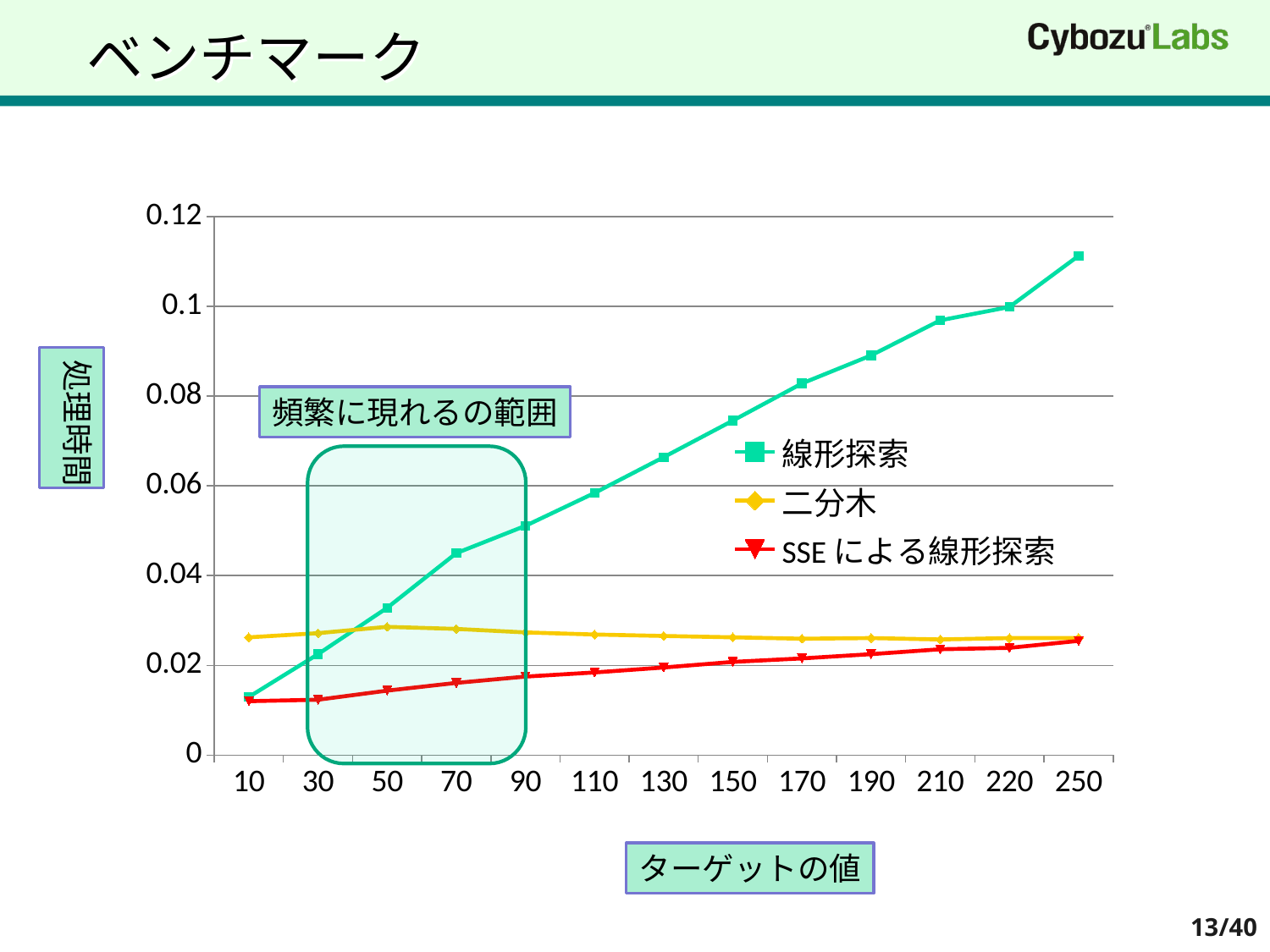
At x = 10, which is larger: 二分木 or SSE による線形探索? 二分木 Is the value of 線形探索 at 10 greater or less than 0.02? less What is the label shown for the x axis of the chart? ターゲットの値 How many series does the legend list? 3 Which series has the lowest value at x = 110? SSE による線形探索 How many points are marked along the x axis? 13 Is the value of 二分木 at 50 greater or less than 0.04? less Is the value of 線形探索 at 250 greater or less than 0.1? greater Does the 線形探索 series rise or fall as the x-axis value increases? rises What kind of chart is shown on the slide? line chart Does the SSE による線形探索 series rise or fall as the x-axis value increases? rises